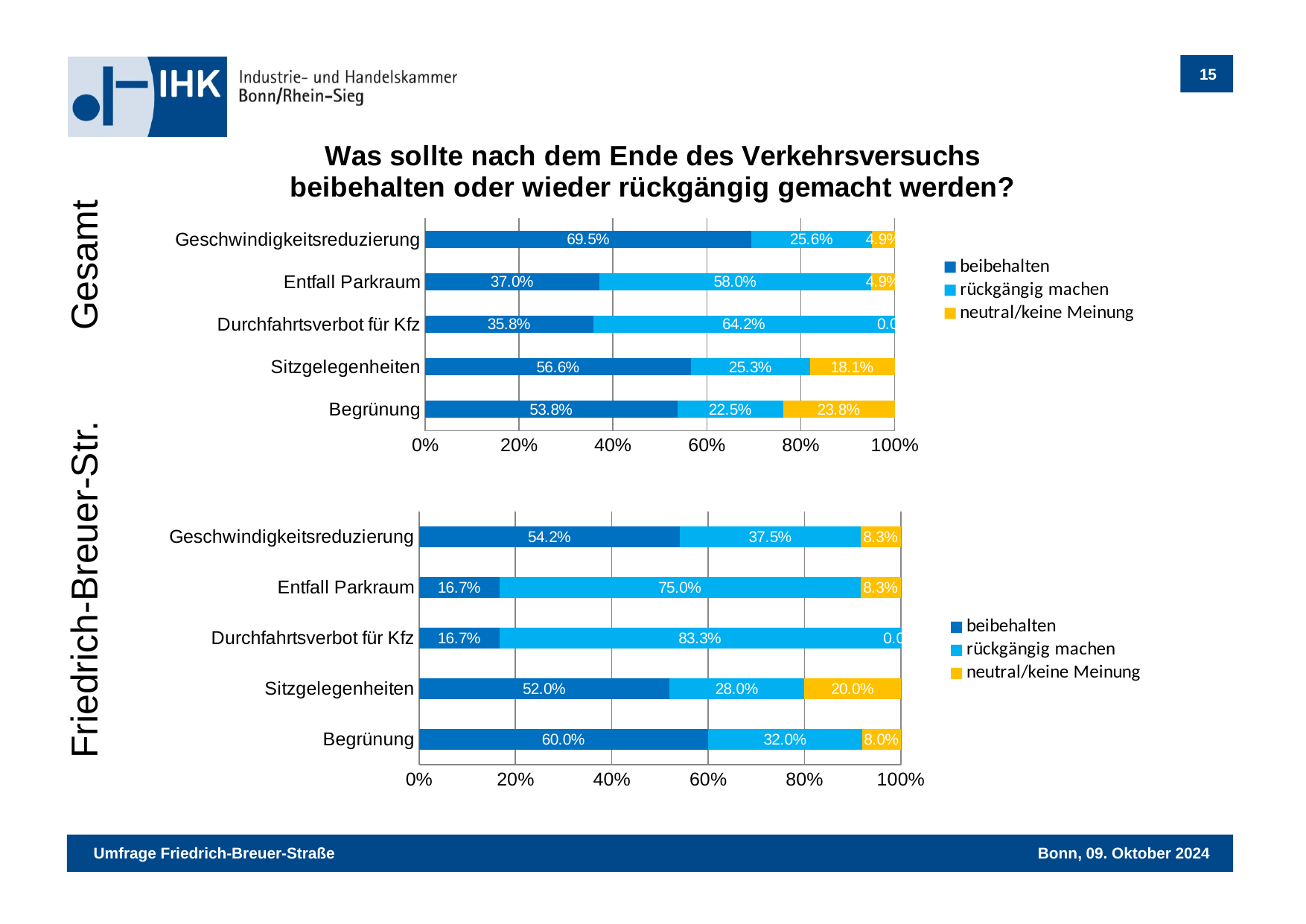
In the bottom chart (Friedrich-Breuer-Str.), which is larger: the 'beibehalten' value for Begrünung or for Geschwindigkeitsreduzierung? Begrünung In the top chart (Gesamt), which category has the highest 'beibehalten' value? Geschwindigkeitsreduzierung In the bottom chart (Friedrich-Breuer-Str.), what is the 'neutral/keine Meinung' value for Sitzgelegenheiten? 20.0% In the bottom chart (Friedrich-Breuer-Str.), what is the 'rückgängig machen' value for Durchfahrtsverbot für Kfz? 83.3% In the top chart (Gesamt), what is the difference between the 'beibehalten' values for Sitzgelegenheiten and Begrünung? 2.8% In the bottom chart (Friedrich-Breuer-Str.), which category has the lowest 'rückgängig machen' value? Sitzgelegenheiten In the top chart (Gesamt), what is the 'rückgängig machen' value for Entfall Parkraum? 58.0% How many series does the legend of the top chart (Gesamt) list? 3 What kind of chart is the top chart (Gesamt)? Stacked bar chart In the top chart (Gesamt), what is the 'beibehalten' value for Geschwindigkeitsreduzierung? 69.5% How many categories are shown in the bottom chart (Friedrich-Breuer-Str.)? 5 In the bottom chart (Friedrich-Breuer-Str.), what is the 'neutral/keine Meinung' value for Begrünung? 8.0%